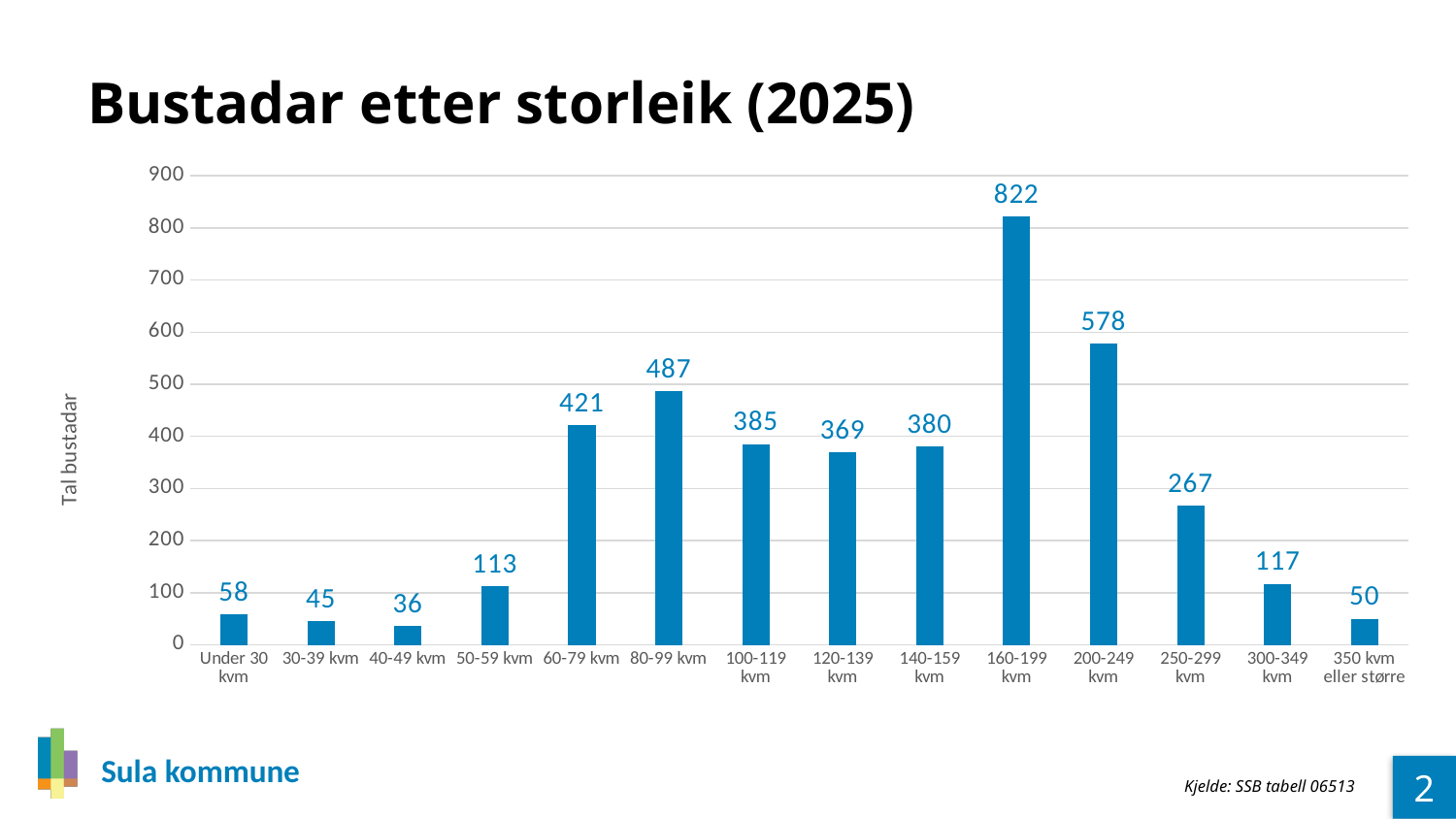
What is the value for Under 30 kvm? 58 What is the title of the chart? Bustadar etter storleik (2025) How many categories are shown on the x axis? 14 What kind of chart is shown on the slide? bar chart What is the value for 250-299 kvm? 267 What is the label of the y axis? Tal bustadar What is the difference between the values for 160-199 kvm and 200-249 kvm? 244 Is the value for 200-249 kvm greater or less than 500? greater Which is larger, the value for 60-79 kvm or the value for 80-99 kvm? 80-99 kvm What is the value for 160-199 kvm? 822 Which category has the highest value? 160-199 kvm Which category has the lowest value? 40-49 kvm